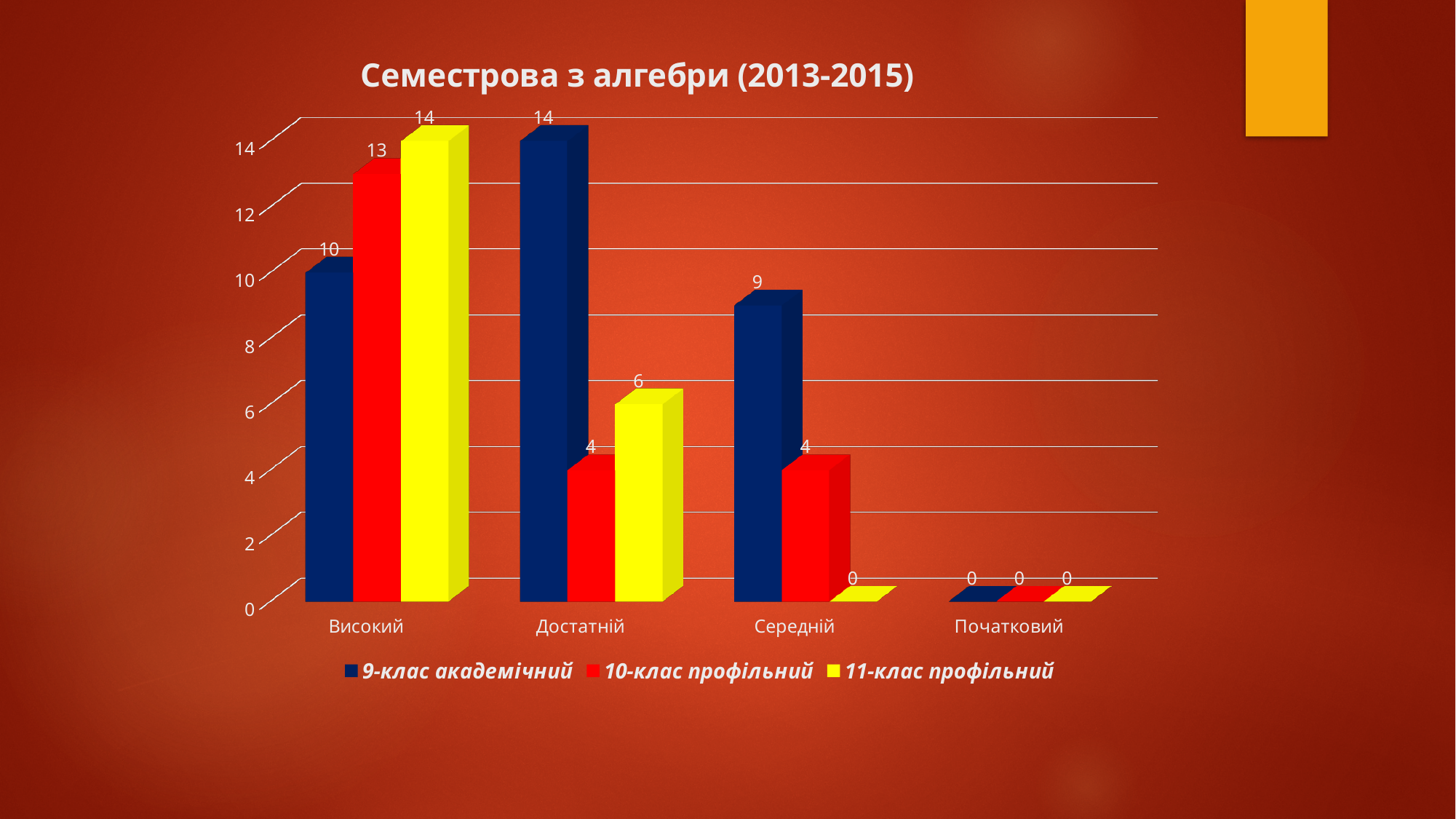
What kind of chart is shown on the slide? bar chart How many series does the legend list? 3 Is the value for 9-клас академічний in the Середній category greater or less than 8? greater How many categories are shown on the x axis? 4 Which category has the lowest value for 10-клас профільний? Початковий Which category has the highest value for 9-клас академічний? Достатній What is the title of the chart? Семестрова з алгебри (2013-2015) What is the difference between the 11-клас профільний value and the 9-клас академічний value in the Високий category? 4 What is the value for 11-клас профільний in the Середній category? 0 In the Достатній category, which series has the larger value: 10-клас профільний or 11-клас профільний? 11-клас профільний What is the value for 10-клас профільний in the Достатній category? 4 What is the value for 9-клас академічний in the Високий category? 10